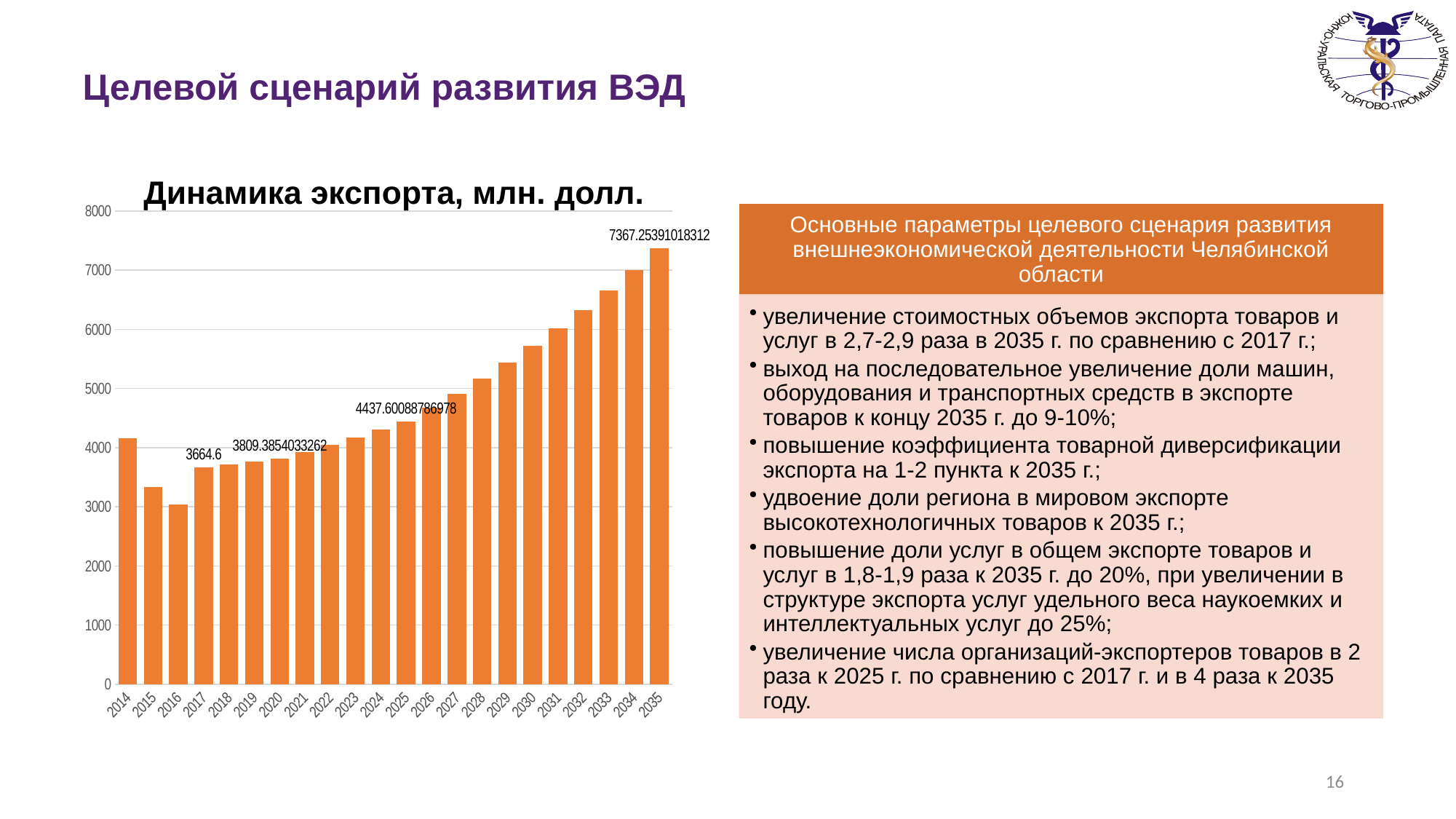
What value is labelled on the 2025 bar in the export dynamics chart? 4437.60088786978 Which year has the larger export value, 2020 or 2025? 2025 What value is labelled on the 2020 bar in the export dynamics chart? 3809.3854033262 Do the export values rise or fall from 2016 to 2035 in the chart? rise What type of chart is used to show 'Динамика экспорта, млн. долл.'? bar chart Is the export value for 2030 greater or less than 5000? greater Which year has the lowest export value in the chart? 2016 What is the data label on the 2035 bar in the export dynamics chart? 7367.25391018312 By how much does the labelled 2035 value exceed the labelled 2017 value in the export chart? 3702.65391018312 How many years (bars) are shown in the export dynamics chart? 22 What is the export value shown for 2017 in the chart 'Динамика экспорта, млн. долл.'? 3664.6 Which year has the highest export value in the chart? 2035